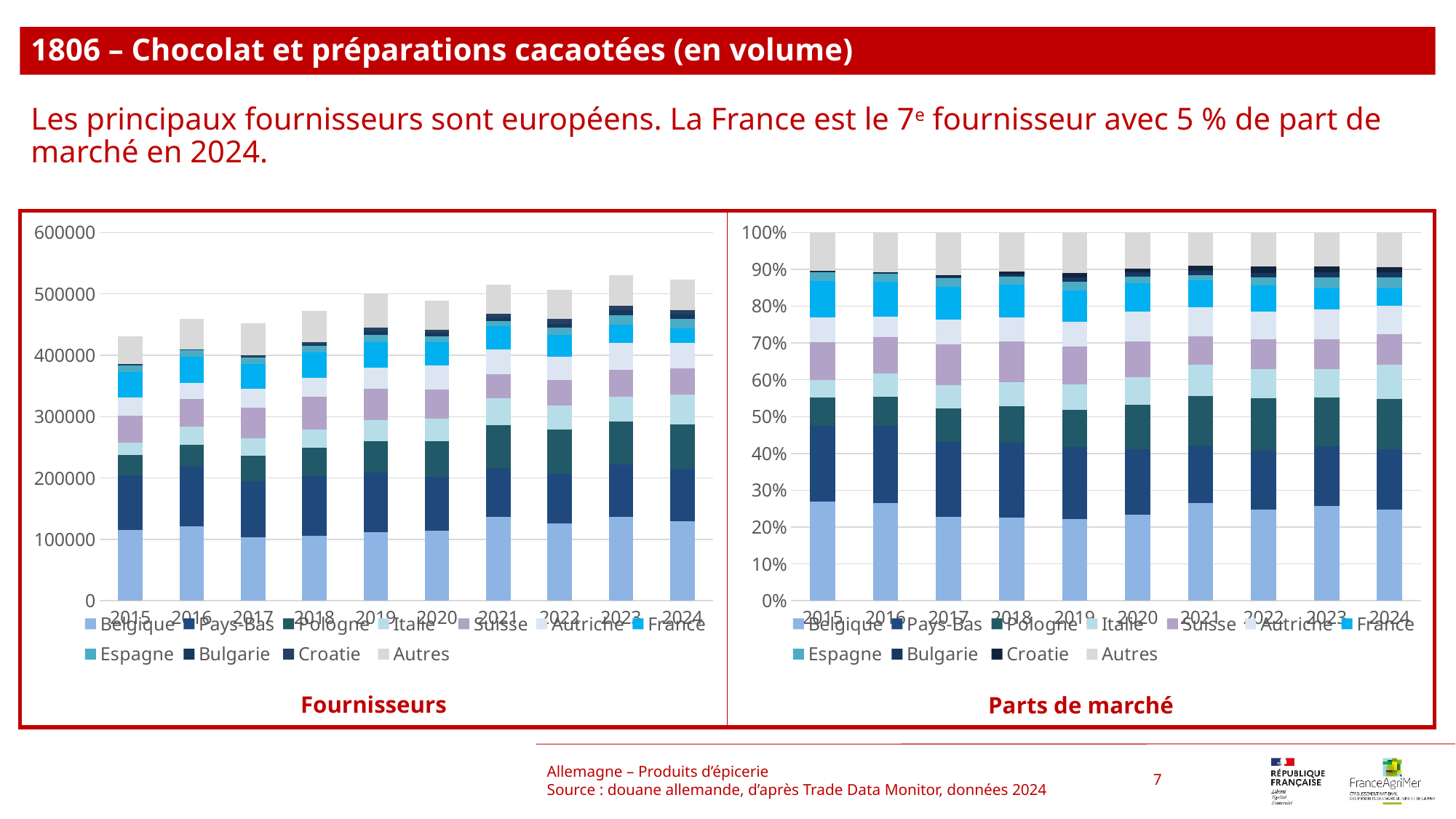
In the "Fournisseurs" chart, is the total bar for 2021 larger or smaller than the total bar for 2017? larger What is the title shown under the right-hand chart? Parts de marché In the "Fournisseurs" chart, which year has the lowest total bar? 2015 In the "Fournisseurs" chart, is the total bar for 2015 greater or less than 500000? less Which series is listed first in the legend of the "Parts de marché" chart? Belgique In the "Fournisseurs" chart, is the total bar for 2023 greater or less than 500000? greater How many series does the legend of the "Fournisseurs" chart list? 11 In the "Parts de marché" chart, is the share of Belgique in 2019 greater or less than 30%? less In the "Fournisseurs" chart, do the total bars generally rise or fall from 2015 to 2024? rise What kind of chart is the "Fournisseurs" chart on the left? Stacked bar chart How many years are shown on the x axis of the "Parts de marché" chart? 10